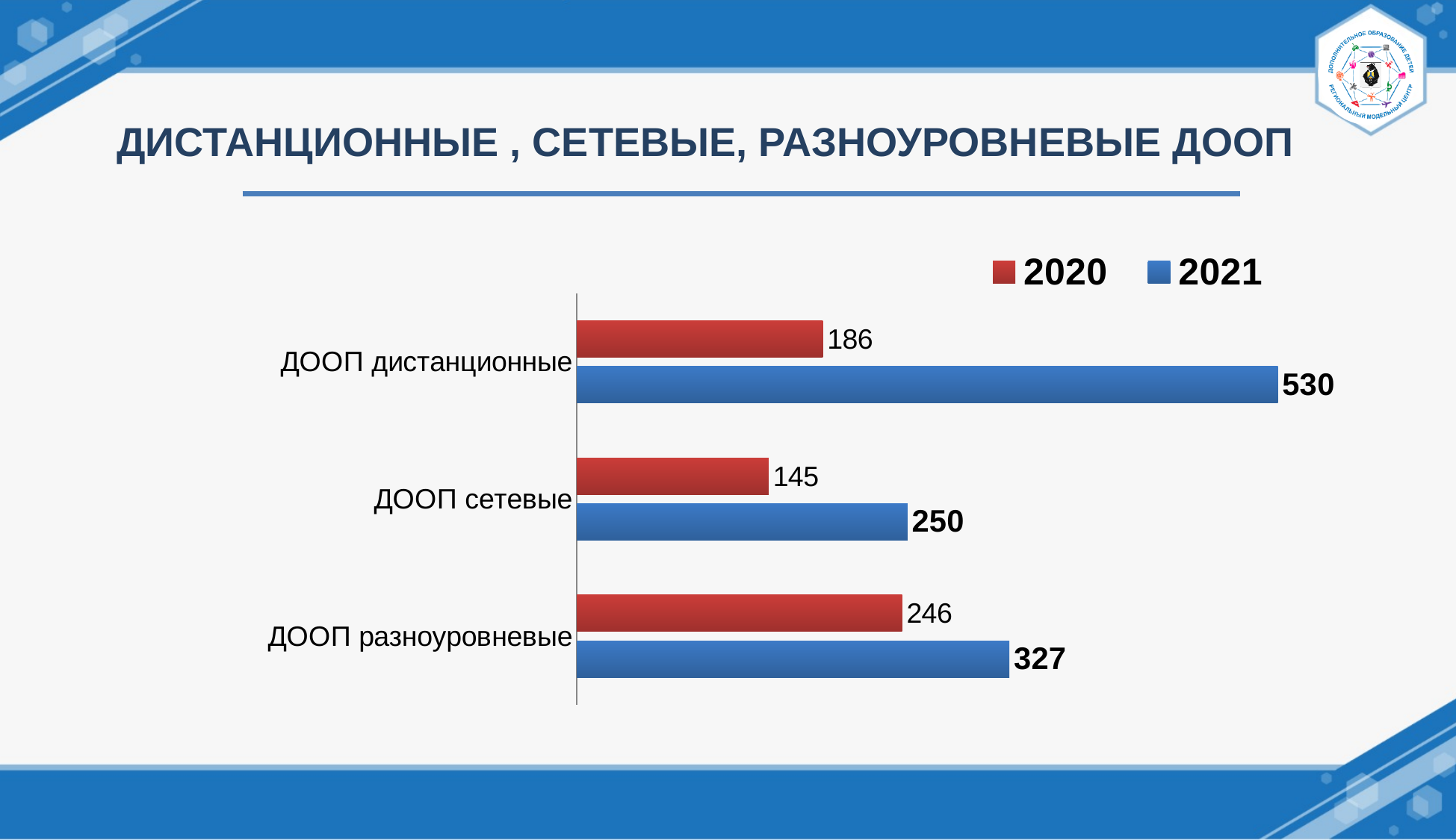
Which category has the highest 2021 value? ДООП дистанционные What is the 2020 value for ДООП сетевые? 145 What kind of chart is shown on the slide? Bar chart What is the 2021 value for ДООП сетевые? 250 Which is larger: the 2020 value for ДООП разноуровневые or the 2021 value for ДООП сетевые? 2021 value for ДООП сетевые How many categories are shown in the chart? 3 What is the 2021 value for ДООП дистанционные? 530 What is the 2020 value for ДООП разноуровневые? 246 What is the difference between the 2021 and 2020 values for ДООП дистанционные? 344 What is the difference between the 2021 and 2020 values for ДООП разноуровневые? 81 How many series does the legend list? 2 Which category has the lowest 2020 value? ДООП сетевые